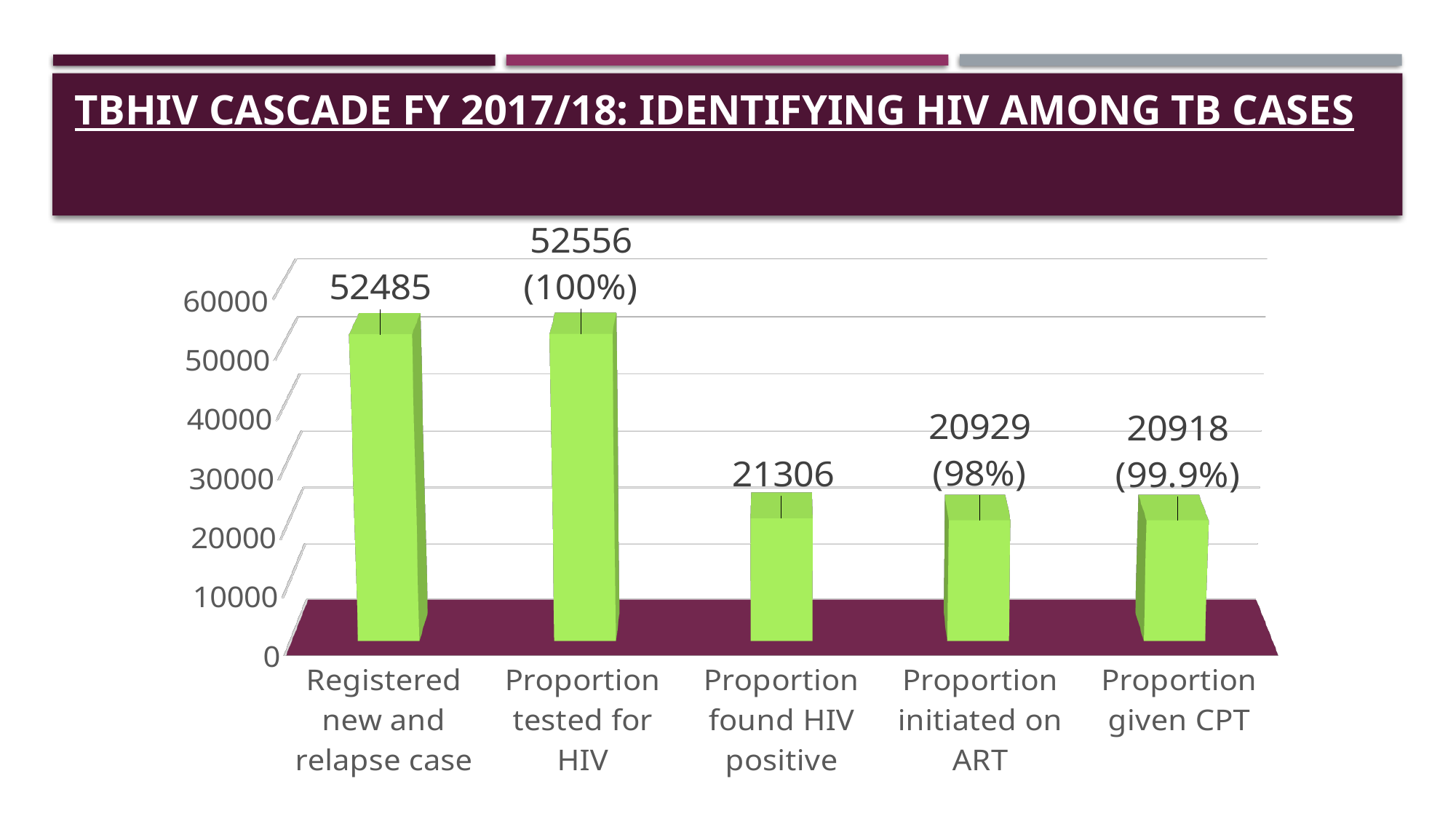
What is the value for Proportion initiated on ART? 20929 (98%) What is the title of the slide? TBHIV CASCADE FY 2017/18: IDENTIFYING HIV AMONG TB CASES Is the value for Proportion found HIV positive greater or less than 30000? less Which category has the highest value? Proportion tested for HIV What is the value for Registered new and relapse case? 52485 What is the value for Proportion given CPT? 20918 (99.9%) What is the difference between Proportion tested for HIV and Registered new and relapse case? 71 Which is larger, Registered new and relapse case or Proportion found HIV positive? Registered new and relapse case What kind of chart is shown on the slide? bar chart How many categories are shown on the x axis? 5 What is the value for Proportion found HIV positive? 21306 What is the difference between Proportion found HIV positive and Proportion initiated on ART? 377